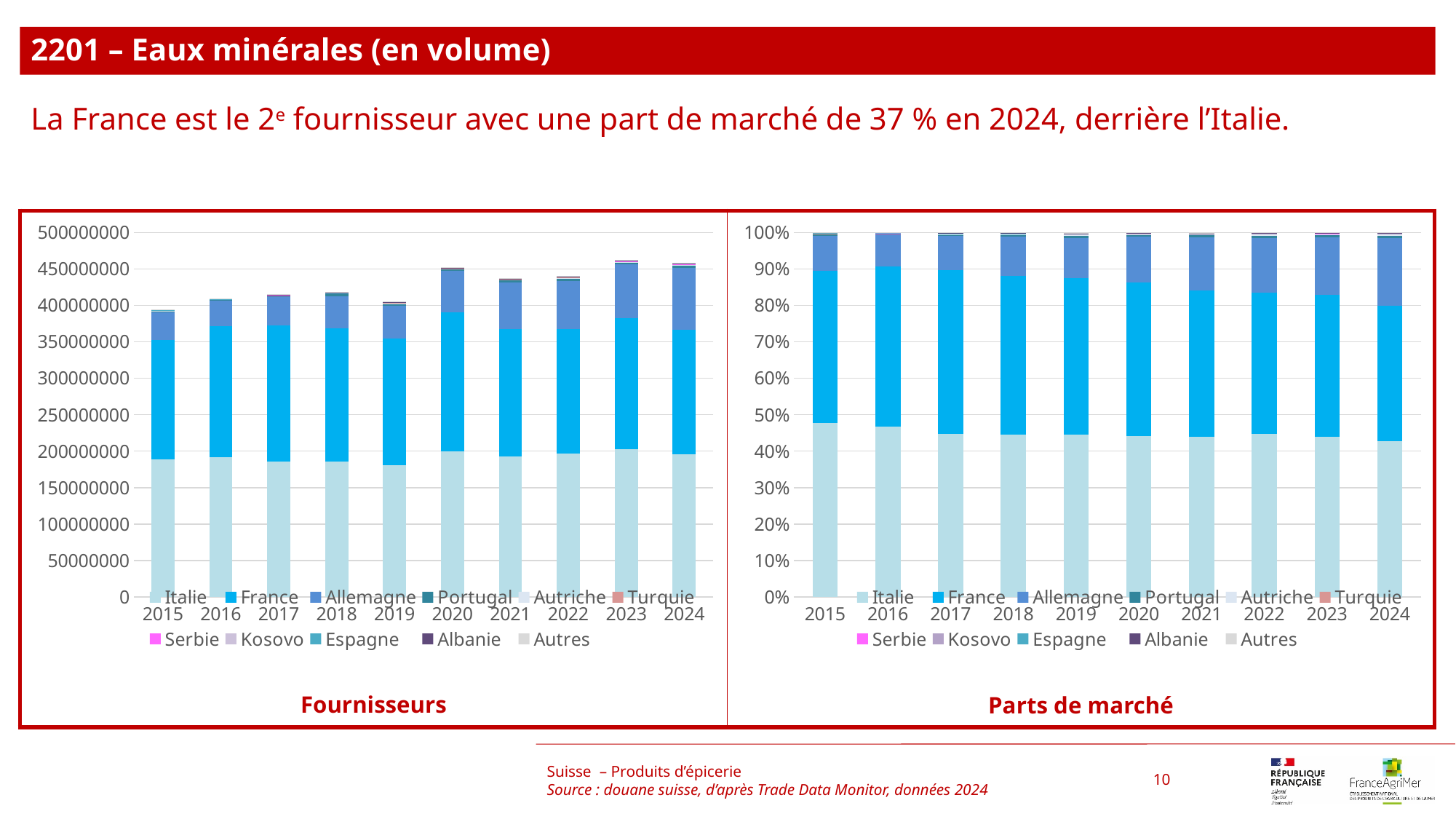
In the 'Parts de marché' chart, is the Italie share in 2024 greater or less than 50%? less In the 'Fournisseurs' chart, is the total bar height for 2023 greater or less than 450000000? greater What is the title of the chart on the right side of the slide? Parts de marché Which series is listed first in the legend of the 'Fournisseurs' chart? Italie How many series does the legend of the 'Fournisseurs' chart list? 11 What kind of chart is the 'Fournisseurs' chart on the left? Stacked bar chart In the 'Fournisseurs' chart, which year has the lowest total bar? 2015 How many years are shown on the x axis of the 'Parts de marché' chart? 10 In the 'Fournisseurs' chart for 2015, which is larger, the Italie segment or the France segment? Italie In the 'Parts de marché' chart, does the Italie share rise or fall from 2015 to 2024? fall In the 'Fournisseurs' chart, is the total bar height for 2015 greater or less than 400000000? less